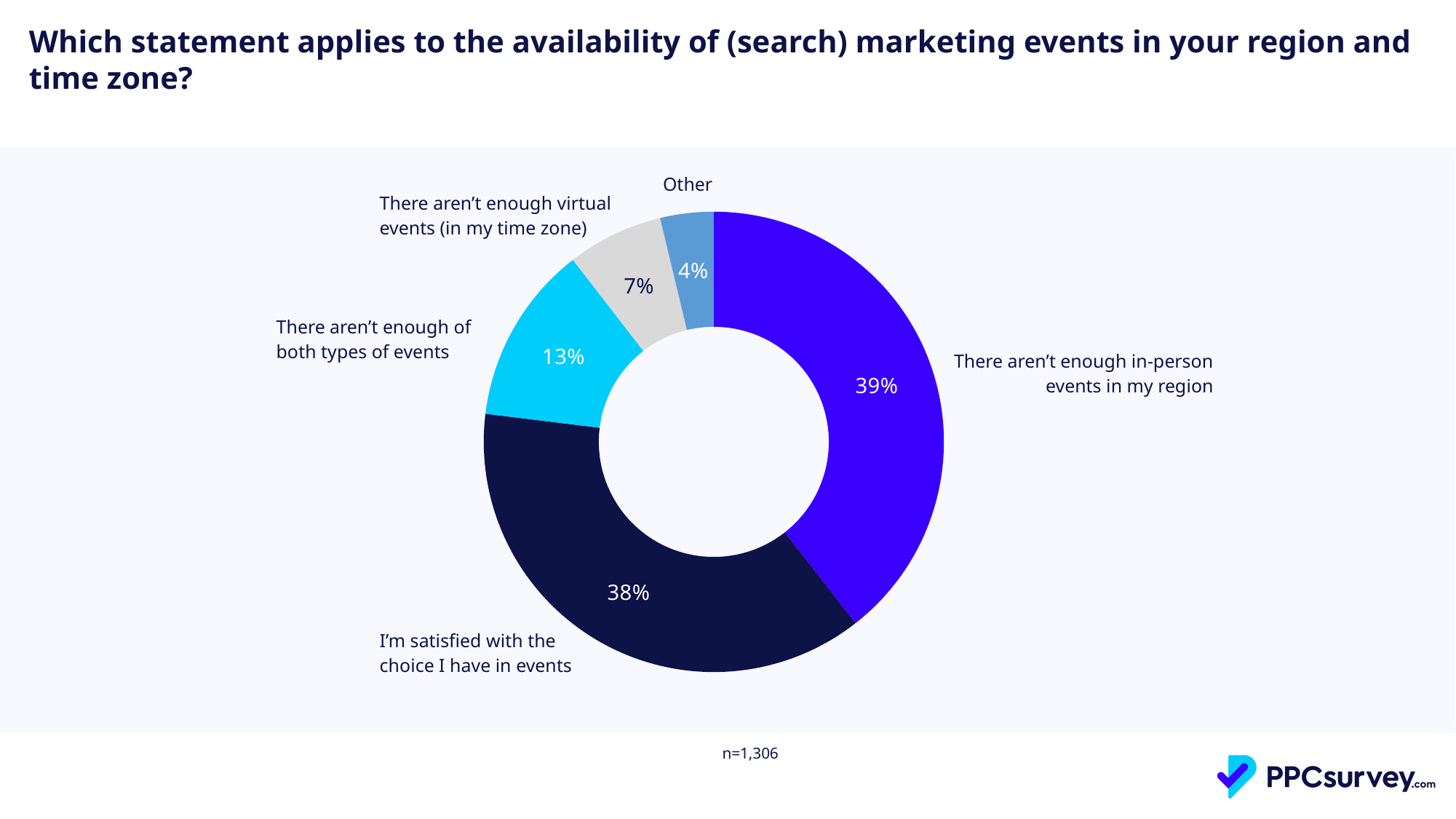
What percentage of respondents said there aren't enough of both types of events? 13% What percentage of respondents said there aren't enough virtual events (in their time zone)? 7% What is the difference in percentage points between 'There aren't enough of both types of events' and 'There aren't enough virtual events (in my time zone)'? 6 percentage points What is the sample size (n) shown on the slide? n=1,306 What percentage of respondents said there aren't enough in-person events in their region? 39% What kind of chart is shown on the slide? Donut (pie) chart Which statement has the largest share of respondents? There aren't enough in-person events in my region Which statement has the smallest share of respondents? Other Which is larger: the share for 'There aren't enough of both types of events' or the share for 'Other'? There aren't enough of both types of events What percentage of respondents chose 'Other'? 4% How many categories are shown in the chart? 5 What percentage of respondents said they are satisfied with the choice they have in events? 38%